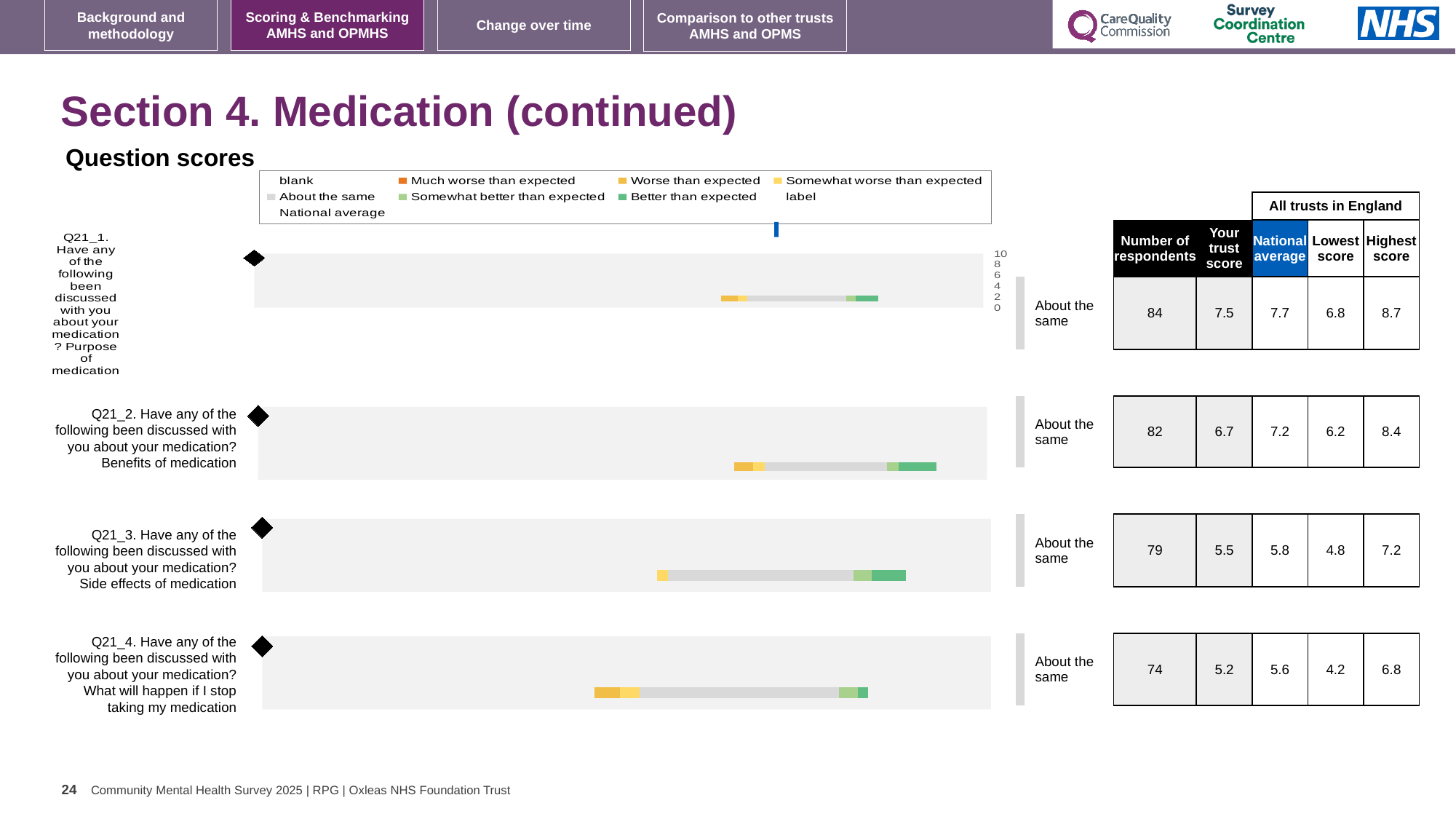
For Q21_2, which is larger: the trust score or the national average? National average What colour does the legend use for 'Much worse than expected'? Orange For Q21_1, what is the difference between the highest score and the lowest score across all trusts in England? 1.9 What is the trust score for Q21_2 (Benefits of medication)? 6.7 What is the national average for Q21_3 (Side effects of medication)? 5.8 How many respondents answered Q21_1 (Purpose of medication)? 84 What benchmark category is shown for Q21_3 (Side effects of medication)? About the same How many questions (bars) are plotted on the slide? 4 What is the lowest score across all trusts in England for Q21_4 (What will happen if I stop taking my medication)? 4.2 Which question has the highest trust score? Q21_1 (Purpose of medication) What kind of chart is used to show the question scores on this slide? bar chart Which question has the lowest national average? Q21_4 (What will happen if I stop taking my medication)